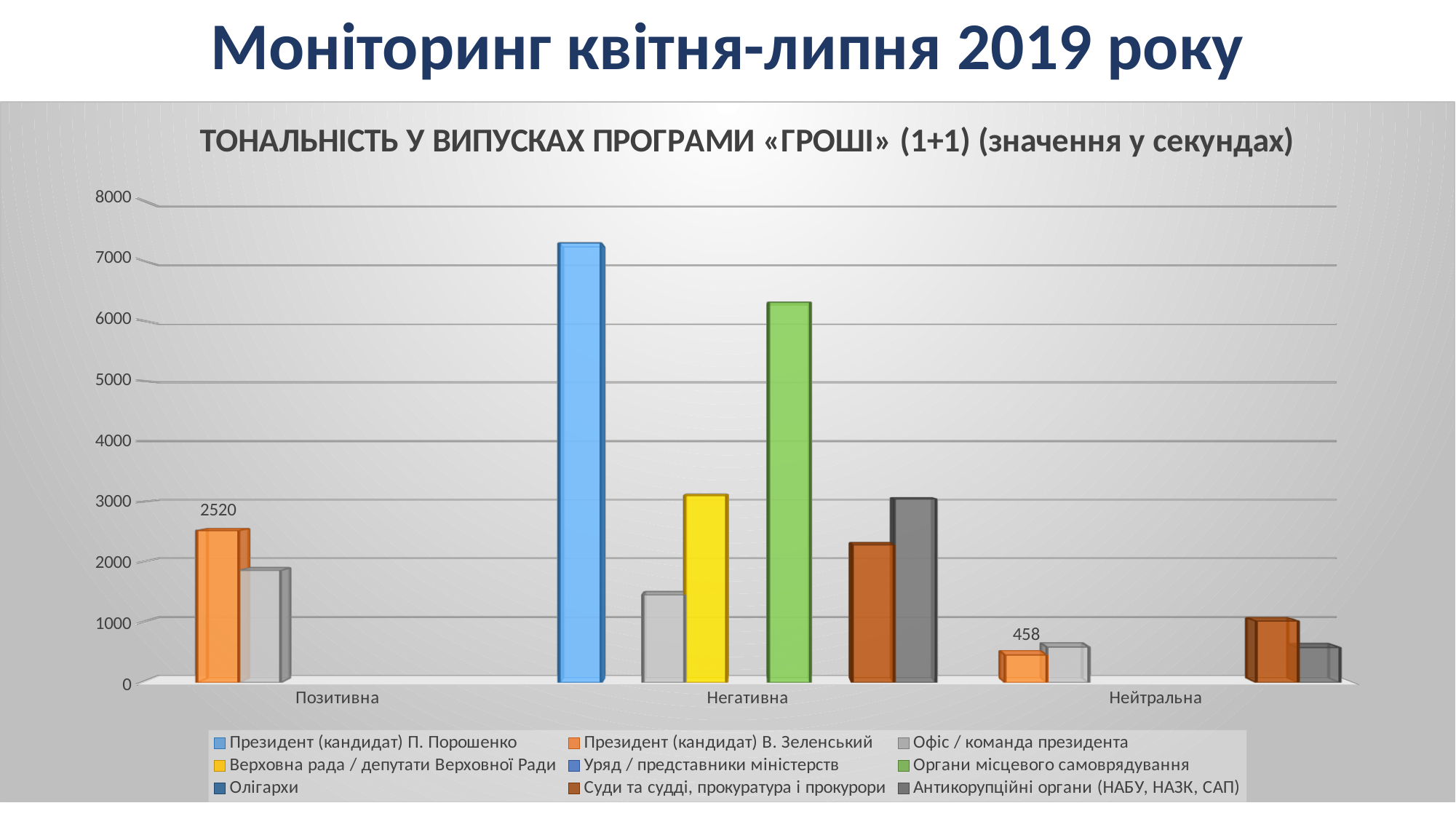
Is the value for Офіс / команда президента in the Позитивна category greater or less than 2000? less What is the difference between the Позитивна and Нейтральна values for Президент (кандидат) В. Зеленський? 2062 Which series has the tallest bar in the Негативна category? Президент (кандидат) П. Порошенко Is the value for Органи місцевого самоврядування in the Негативна category greater or less than 6000? greater In the Негативна category, which is larger: Верховна рада / депутати Верховної Ради or Офіс / команда президента? Верховна рада / депутати Верховної Ради Is the value for Президент (кандидат) П. Порошенко in the Негативна category greater or less than 7000? greater What kind of chart is shown on the slide? bar chart In the Позитивна category, which is larger: Президент (кандидат) В. Зеленський or Офіс / команда президента? Президент (кандидат) В. Зеленський What is the value for Президент (кандидат) В. Зеленський in the Позитивна category? 2520 What is the value for Президент (кандидат) В. Зеленський in the Нейтральна category? 458 How many categories are shown on the x axis? 3 How many series does the legend list? 9